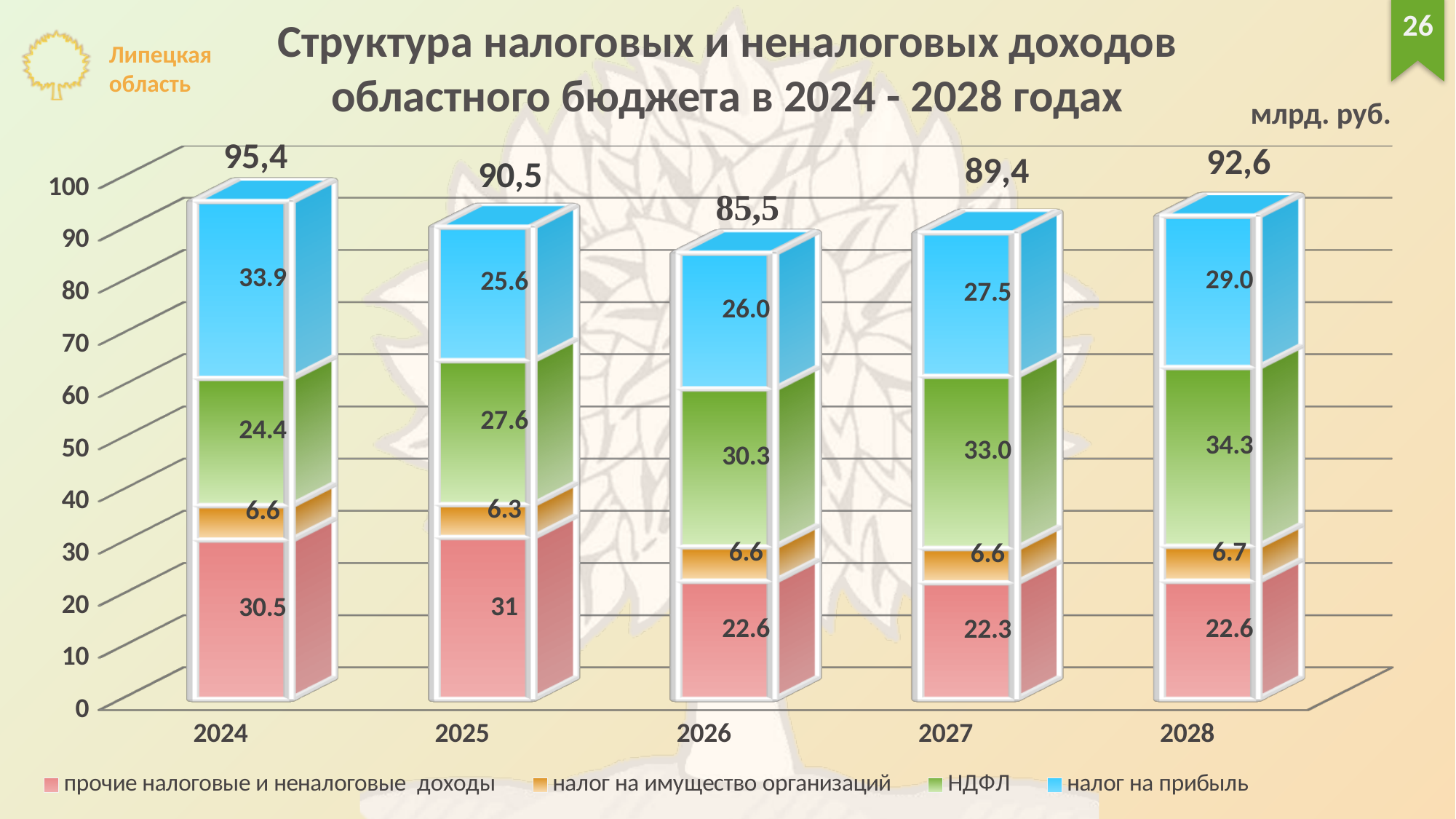
Which year has the highest total? 2024 What is the value for прочие налоговые и неналоговые доходы in 2027? 22.3 Which is larger: налог на прибыль in 2025 or in 2026? 2026 What kind of chart is shown on the slide? stacked bar chart How many years are shown on the x axis? 5 What is the difference between the НДФЛ values for 2027 and 2024? 8.6 What is the value for налог на прибыль in 2024? 33.9 What is the total shown above the bar for 2026? 85,5 What is the value for НДФЛ in 2028? 34.3 Which year has the lowest total? 2026 How many series does the legend list? 4 What is the value for налог на имущество организаций in 2025? 6.3